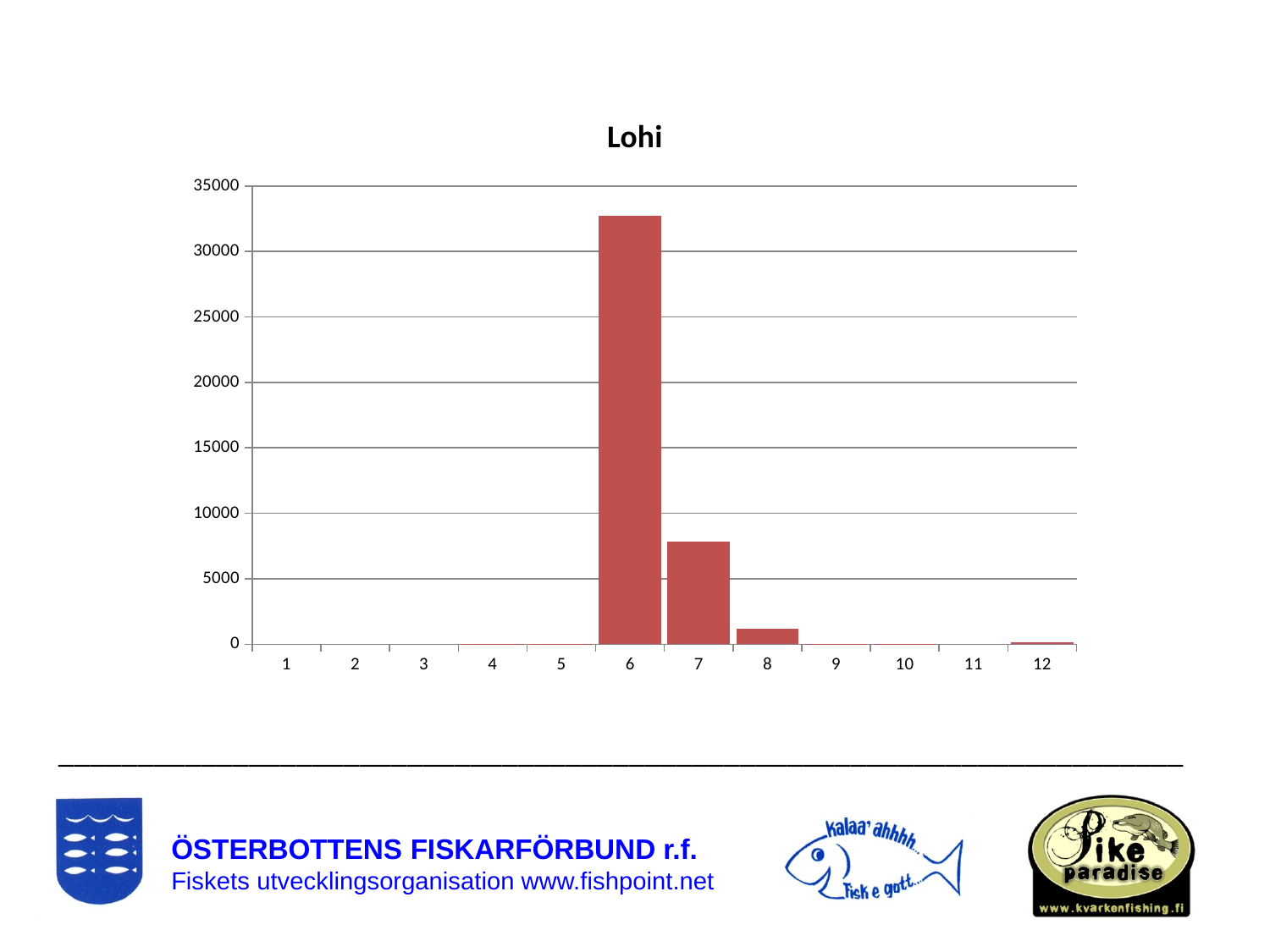
Is the value for category 8 greater or less than 5000? less Is the value for category 7 greater or less than 5000? greater Is the value for category 6 greater or less than 30000? greater What is the title of the chart? Lohi Do the values rise or fall from category 6 to category 8? fall Which category has the highest value in the chart? 6 Which has the larger value, category 7 or category 8? 7 How many categories are shown on the x axis of the chart? 12 Which has the larger value, category 6 or category 7? 6 What kind of chart is shown on the slide? bar chart